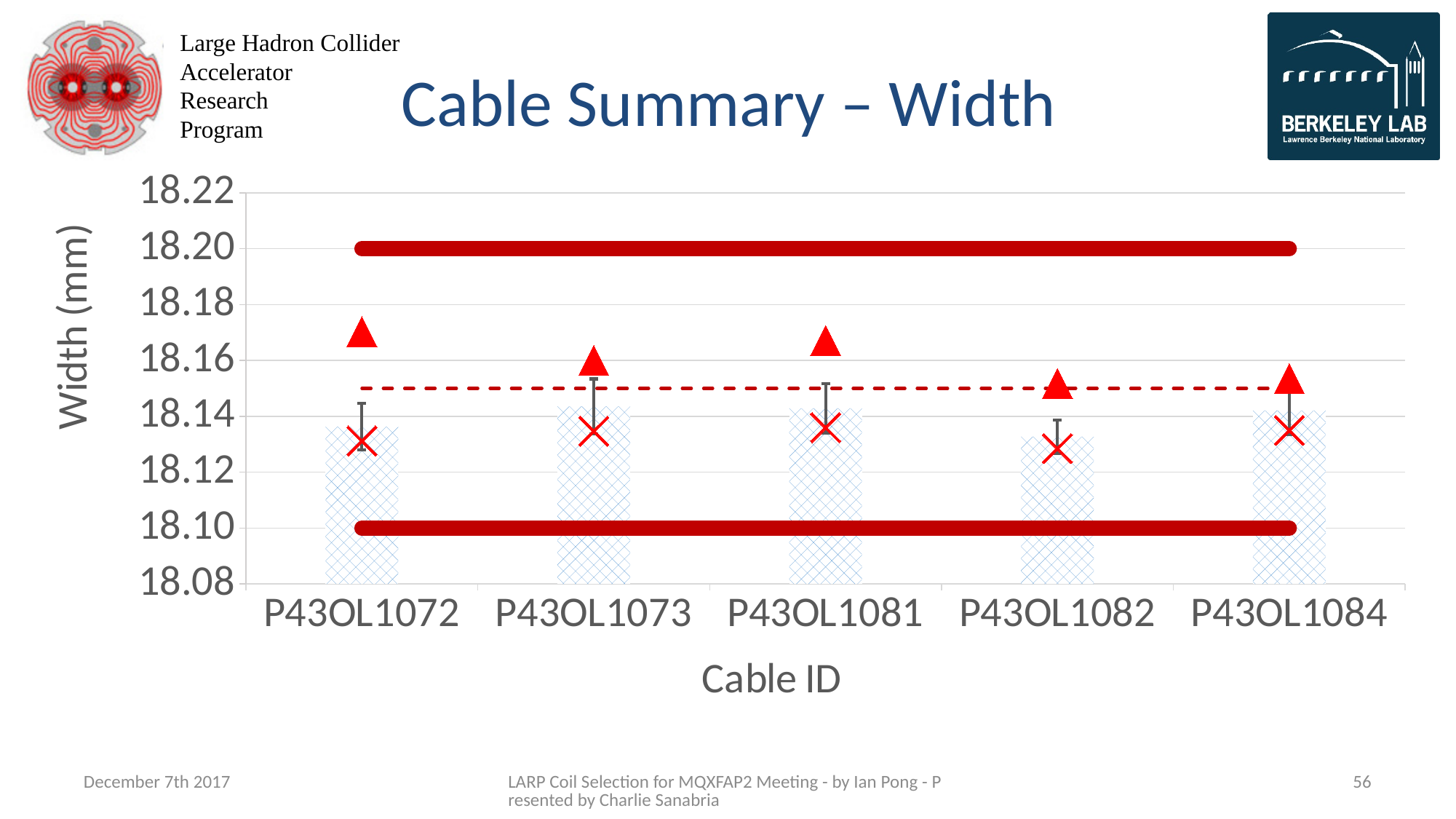
Is the triangle marker value for P43OL1081 greater or less than 18.16? greater At what width value is the upper thick solid red line drawn? 18.20 What kind of chart is shown on the slide? bar chart How many cable IDs are shown on the x axis of the chart? 5 Is the triangle marker value for P43OL1084 greater or less than 18.18? less Which has the larger triangle marker value, P43OL1072 or P43OL1082? P43OL1072 Is the triangle marker value for P43OL1072 greater or less than 18.16? greater Which has the larger bar value, P43OL1073 or P43OL1082? P43OL1073 What is the label of the vertical axis of the chart? Width (mm) What is the title of the chart? Cable Summary – Width